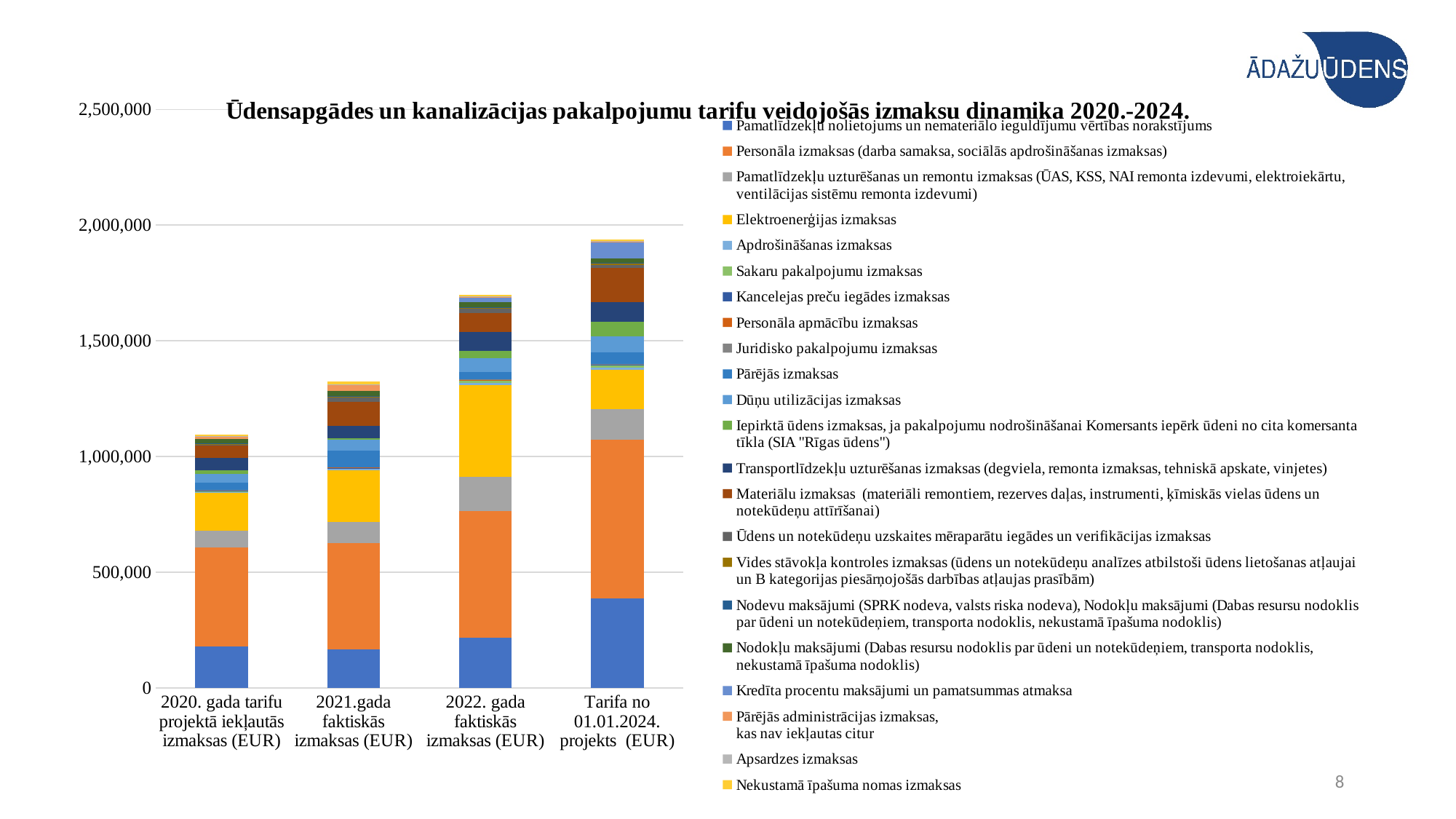
Is the total for 2022. gada faktiskās izmaksas (EUR) greater or less than 1,500,000? greater How many series does the legend list? 22 Is the total for 2021.gada faktiskās izmaksas (EUR) greater or less than 1,500,000? less Do the total stacked bar values rise or fall from left to right along the x axis? Rise What is the title of the chart? Ūdensapgādes un kanalizācijas pakalpojumu tarifu veidojošās izmaksu dinamika 2020.-2024. Is the total for Tarifa no 01.01.2024. projekts (EUR) greater or less than 2,000,000? less Which category has the lowest total stacked bar? 2020. gada tarifu projektā iekļautās izmaksas (EUR) What kind of chart is shown on the slide? Stacked bar chart How many bars (categories) are plotted on the x axis? 4 Which has the larger total stacked bar: 2021.gada faktiskās izmaksas (EUR) or 2022. gada faktiskās izmaksas (EUR)? 2022. gada faktiskās izmaksas (EUR) Which category has the highest total stacked bar? Tarifa no 01.01.2024. projekts (EUR)